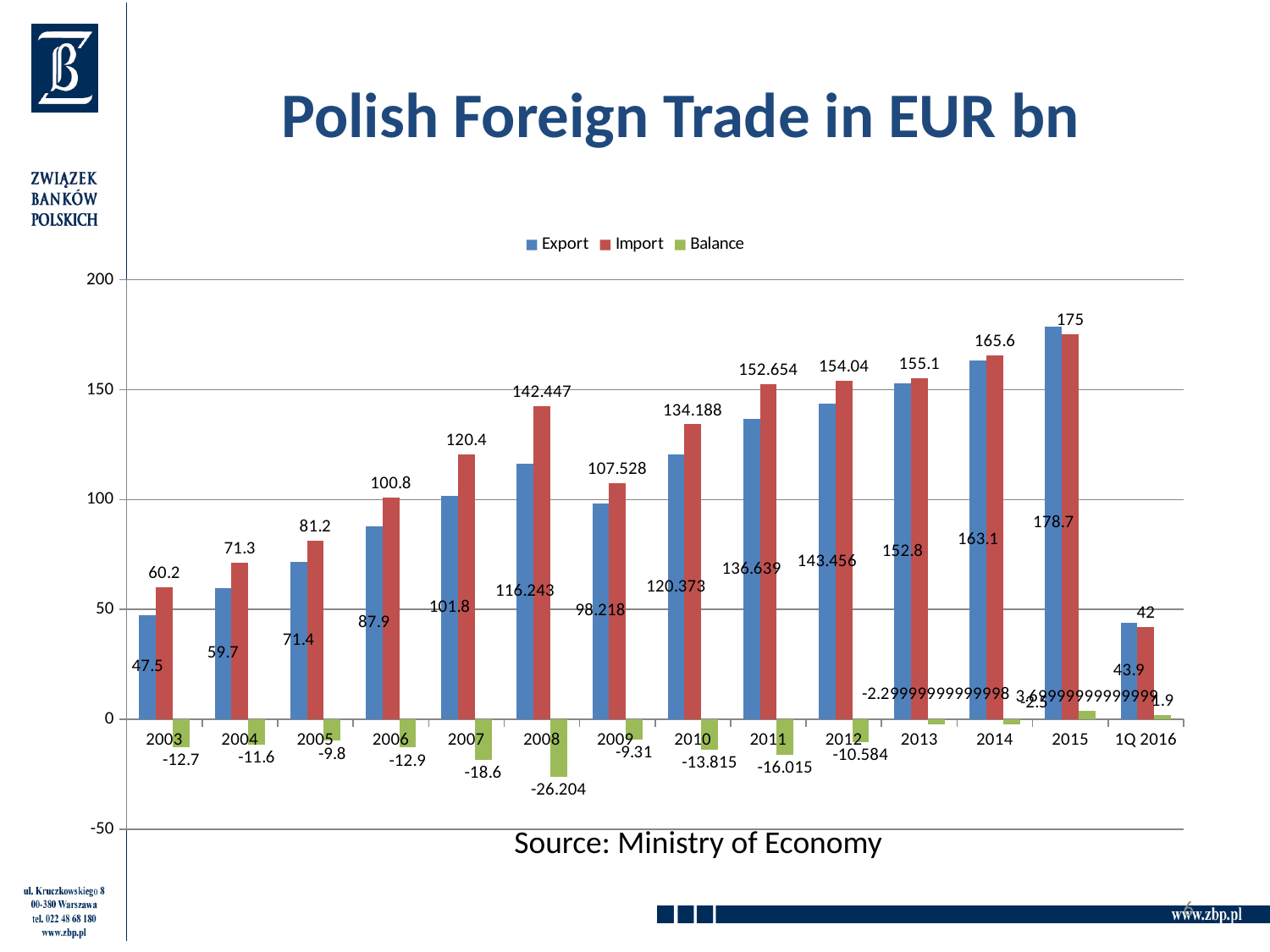
What is the Import value for 2008? 142.447 What kind of chart is shown on the slide? Bar chart What is the Export value for 2011? 136.639 How many series does the legend list? 3 Do the Export values rise or fall from 2003 to 2008? Rise How many categories are shown on the x axis? 14 Which is larger in 2015, Export or Import? Export What is the Balance value for 2008? -26.204 Which category has the lowest Import value? 1Q 2016 What is the difference between the Import and Export values in 2003? 12.7 What is the Export value for 2015? 178.7 In which year is the Export value highest? 2015